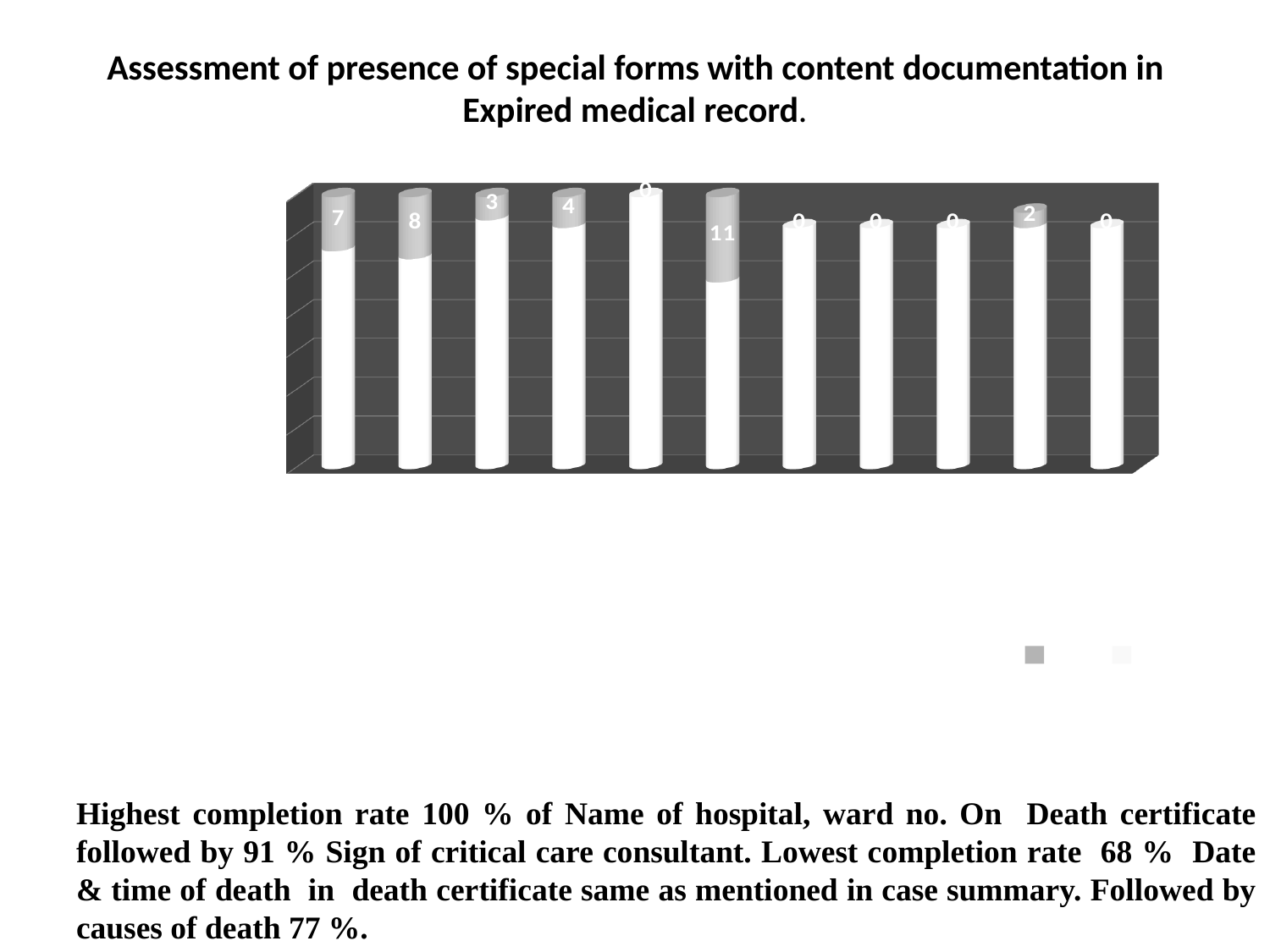
What kind of chart is shown on the slide? bar chart How many series does the legend list? 2 What is the data label on the grey segment of the tenth bar from the left? 2 Which has a larger grey segment value, the second bar (8) or the third bar (3)? the second bar Which bar has the largest grey segment value? the sixth bar from the left (11) What is the difference between the grey segment values of the sixth bar (11) and the first bar (7)? 4 What is the data label on the grey segment of the second bar from the left? 8 How many bars are plotted in the chart? 11 What is the data label on the grey segment of the first bar from the left? 7 What is the data label on the grey segment of the sixth bar from the left? 11 How many bars have a grey segment labelled 0? 5 What is the title of the chart on the slide? Assessment of presence of special forms with content documentation in Expired medical record.